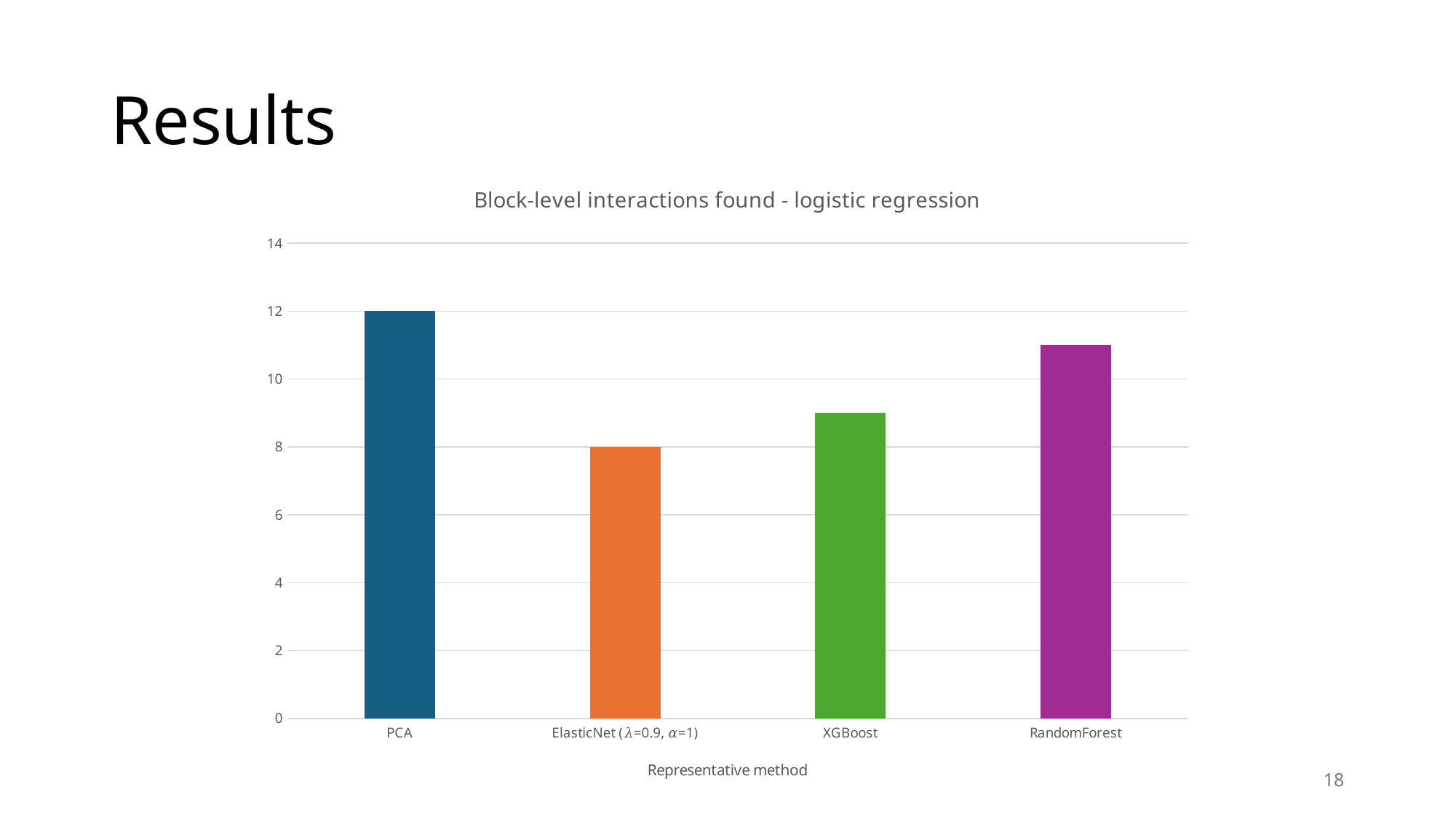
Is the value for XGBoost greater or less than 10? less Is the value for RandomForest greater or less than 10? greater Which is larger, the value for XGBoost or the value for ElasticNet (λ=0.9, α=1)? XGBoost How many representative methods are shown on the x axis? 4 Which representative method has the highest number of block-level interactions found? PCA What is the value for PCA? 12 Which is larger, the value for PCA or the value for RandomForest? PCA Which representative method has the lowest number of block-level interactions found? ElasticNet (λ=0.9, α=1) What kind of chart is shown on the slide? Bar chart What is the difference between the values for PCA and ElasticNet (λ=0.9, α=1)? 4 What is the value for ElasticNet (λ=0.9, α=1)? 8 What is the title of the chart? Block-level interactions found - logistic regression